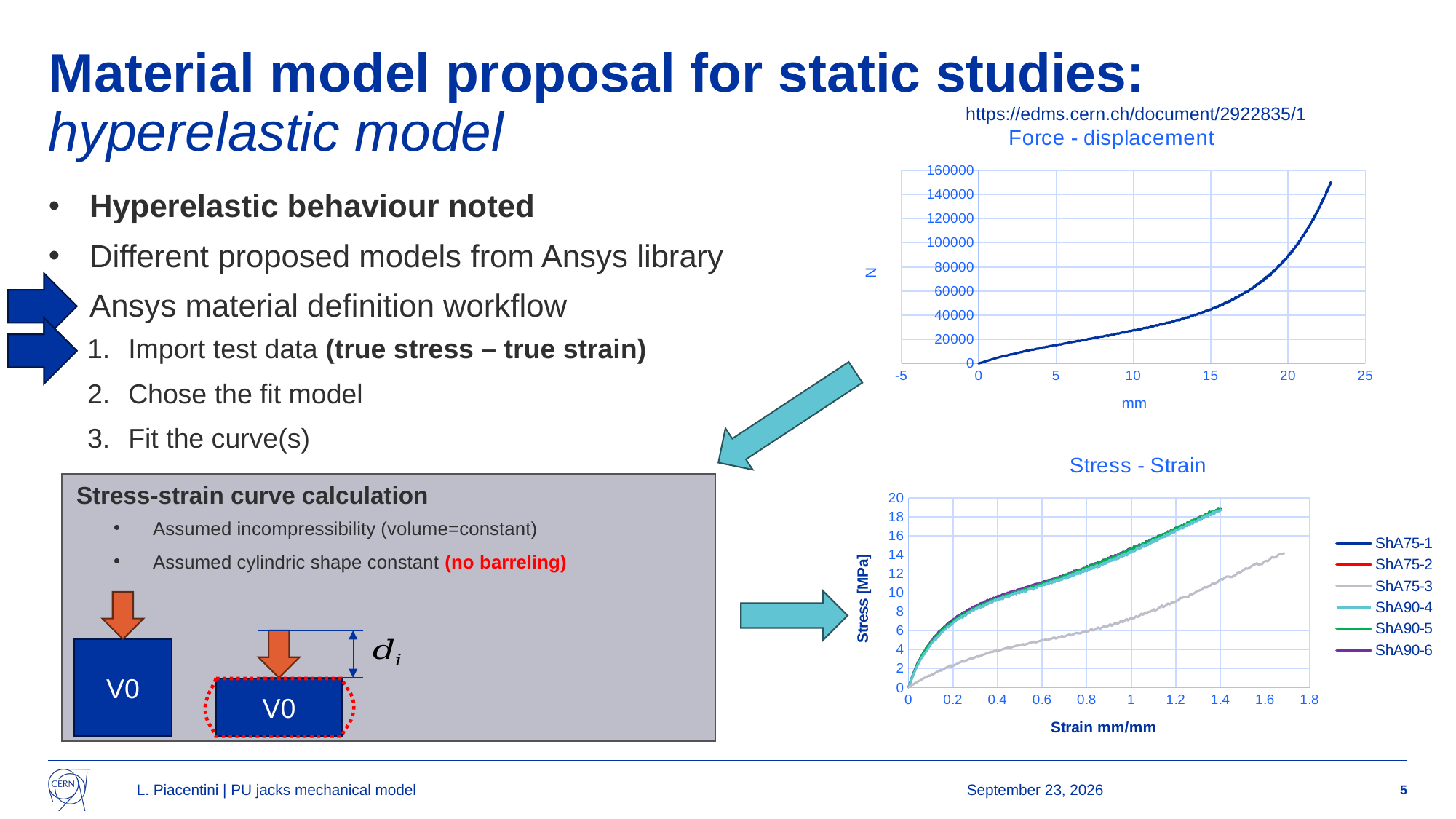
In the 'Force - displacement' chart, is the highest force reached greater or less than 140000? greater In the 'Stress - Strain' chart, does stress rise or fall as strain increases? rise In the 'Stress - Strain' chart, is the stress of ShA75-3 at a strain of 1.4 greater or less than 14? less What kind of chart is the 'Stress - Strain' chart? line chart In the 'Stress - Strain' chart, is the highest stress reached by ShA90-5 greater or less than 16? greater In the 'Stress - Strain' chart, what is the label of the y axis? Stress [MPa] What kind of chart is the 'Force - displacement' chart? line chart In the 'Force - displacement' chart, what is the label of the x axis? mm In the 'Stress - Strain' chart, which series has the lowest stress values? ShA75-3 How many series does the legend of the 'Stress - Strain' chart list? 6 In the 'Force - displacement' chart, does the force rise or fall as displacement increases? rise